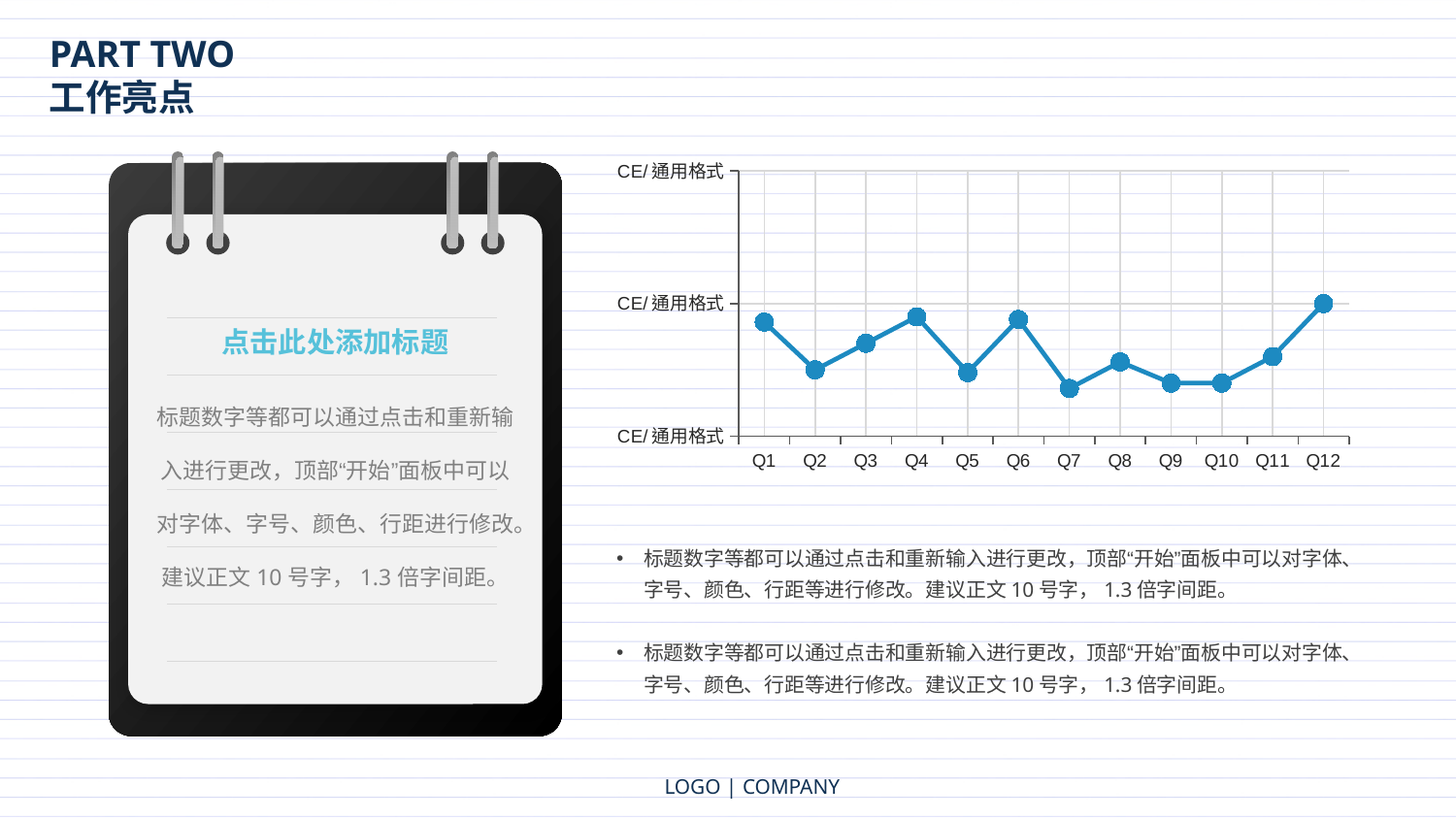
Which quarter has the highest value on the line chart? Q12 Do the values on the line chart rise or fall from Q10 to Q12? rise Which is larger on the line chart, the value for Q6 or the value for Q5? Q6 Which is larger on the line chart, the value for Q1 or the value for Q2? Q1 Do the values on the line chart rise or fall from Q1 to Q2? fall What is the label of the first category on the x axis of the line chart? Q1 Which is larger on the line chart, the value for Q11 or the value for Q10? Q11 What kind of chart is shown on the slide? line chart How many data points are plotted on the line chart? 12 What colour is the line plotted on the chart? blue